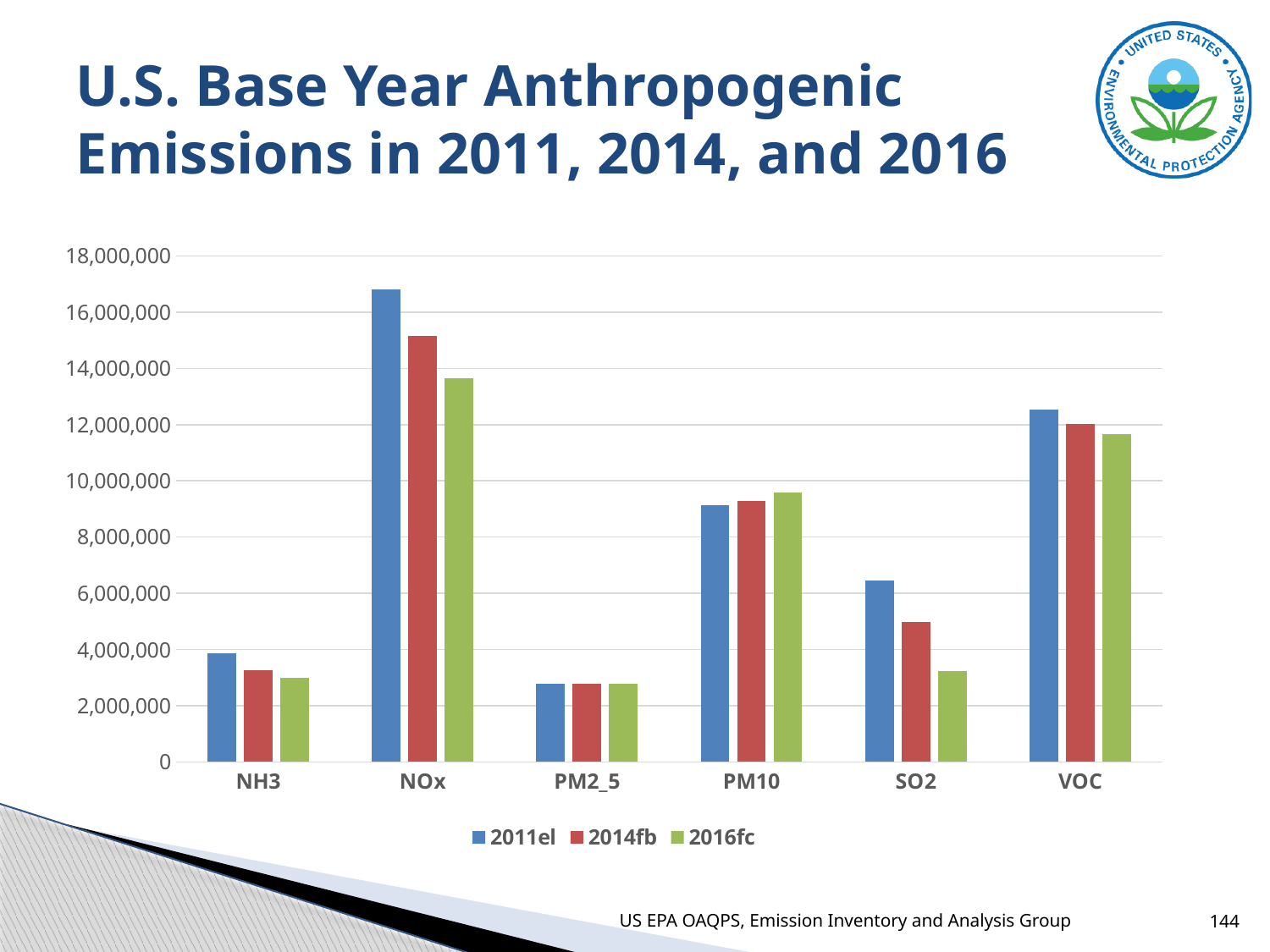
Which has the larger 2011el value: NH3 or VOC? VOC For SO2, which is larger: the 2011el value or the 2014fb value? 2011el For SO2, do the values rise or fall from 2011el to 2014fb to 2016fc? fall Which pollutant has the lowest 2011el emissions? PM2_5 How many pollutant categories are shown on the x axis? 6 Is the 2016fc value for SO2 greater or less than 4,000,000? less Is the 2016fc value for PM10 greater or less than 10,000,000? less Is the 2011el value for NOx greater or less than 16,000,000? greater How many series does the legend list? 3 What kind of chart is shown on the slide? bar chart What are the three series names listed in the legend? 2011el, 2014fb, 2016fc Which pollutant has the highest 2011el emissions? NOx